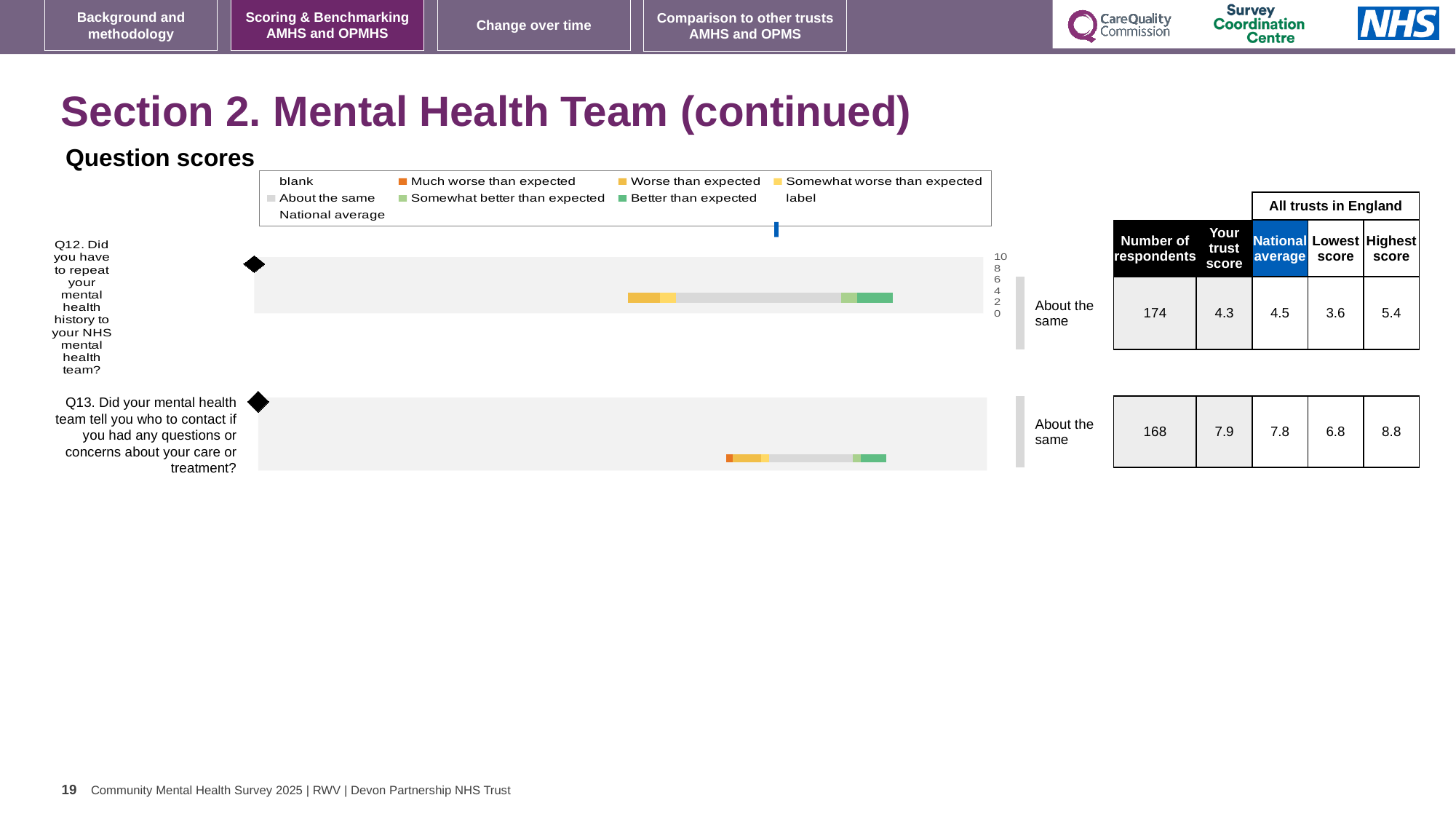
What is the trust score for Q12 (repeating mental health history)? 4.3 What kind of chart is used to show the question scores on this slide? bar chart What is the difference between the highest and lowest trust scores in England for Q13? 2.0 How many questions are plotted in the question scores chart? 2 What benchmark category is shown for Q13? About the same What is the highest score among all trusts in England for Q12? 5.4 How many entries does the legend of the question scores chart list? 9 How many respondents answered Q12? 174 What is the national average score for Q13? 7.8 Is the trust score for Q12 higher or lower than the national average? lower What is the trust score for Q13 (told who to contact with questions or concerns)? 7.9 Which question has the higher trust score, Q12 or Q13? Q13